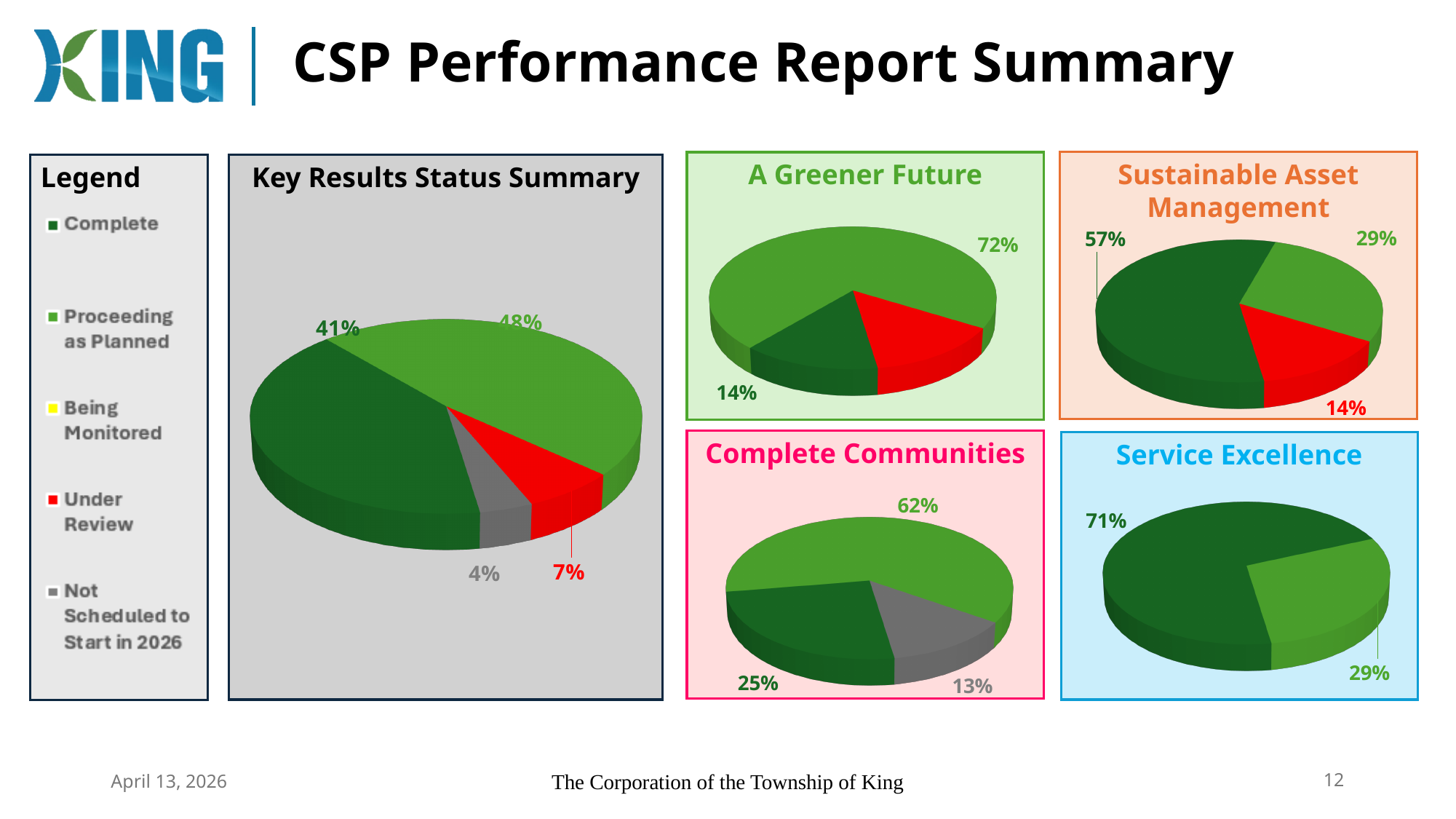
In the Complete Communities chart, what share is Not Scheduled to Start in 2026? 13% In the A Greener Future chart, what is the difference between the Proceeding as Planned share and the Complete share? 58% In the Sustainable Asset Management chart, what share is Complete? 57% In the Sustainable Asset Management chart, which is larger, the Proceeding as Planned share or the Under Review share? Proceeding as Planned In the Service Excellence chart, what share is Complete? 71% What kind of chart is used in the Service Excellence panel? Pie chart In the Complete Communities chart, which status has the largest share? Proceeding as Planned In the Key Results Status Summary chart, what percentage of key results are Under Review? 7% In the Key Results Status Summary chart, which status has the smallest share? Not Scheduled to Start in 2026 In the A Greener Future chart, what share is Proceeding as Planned? 72% In the Key Results Status Summary chart, how many slices does the pie have? 4 In the Key Results Status Summary chart, what percentage of key results are Proceeding as Planned? 48%